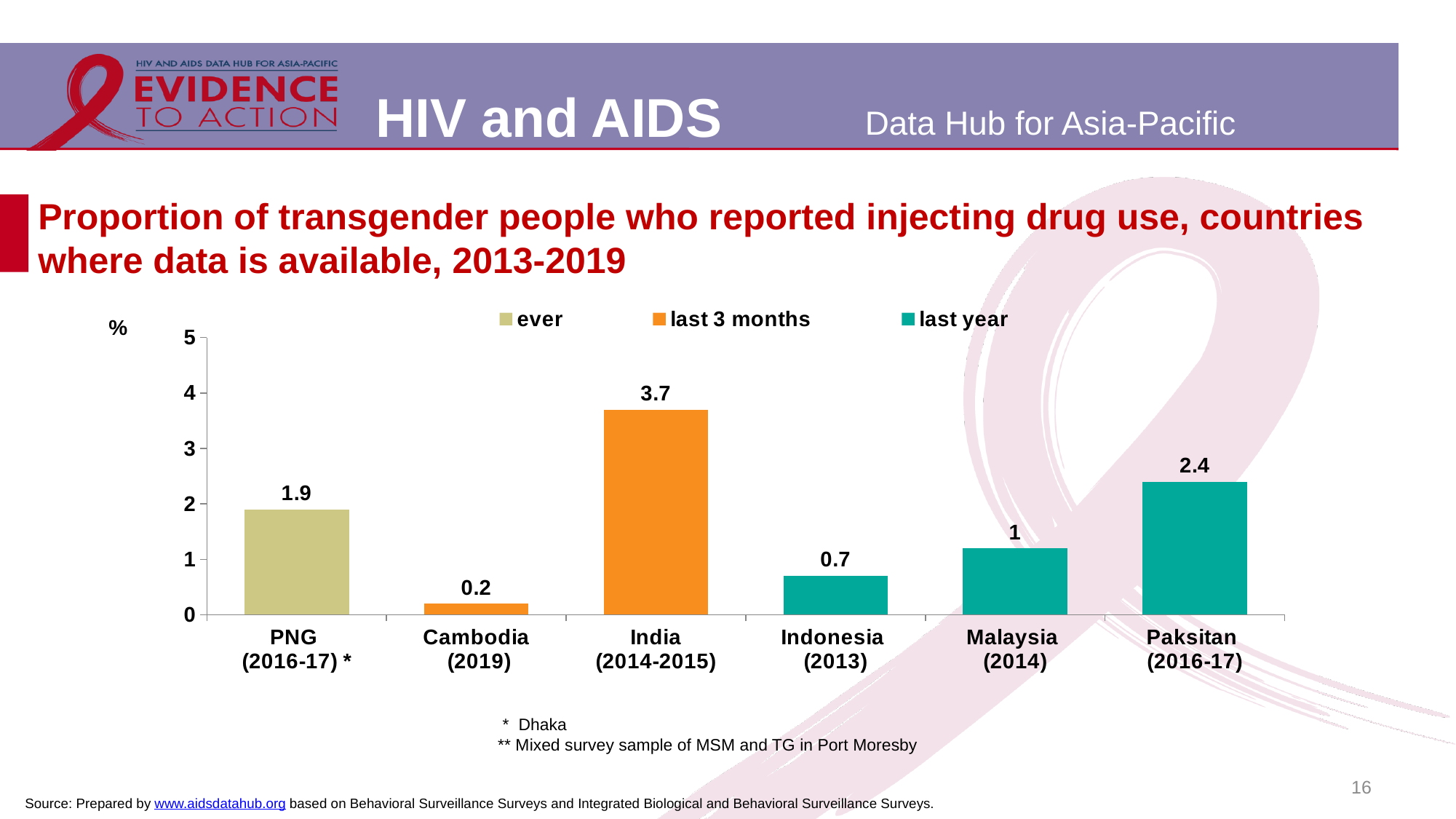
What is the value for Malaysia (2014)? 1 How many countries are shown on the x axis? 6 What kind of chart is shown? bar chart Which legend entry is shown in orange? last 3 months Which is larger, the value for PNG (2016-17) or the value for Indonesia (2013)? PNG (2016-17) Is the value for Paksitan (2016-17) greater or less than 2? greater What is the value for India (2014-2015)? 3.7 Which country has the lowest value? Cambodia (2019) What is the difference between the values for India (2014-2015) and Paksitan (2016-17)? 1.3 What is the value for Cambodia (2019)? 0.2 How many series does the legend list? 3 Which country has the highest value? India (2014-2015)